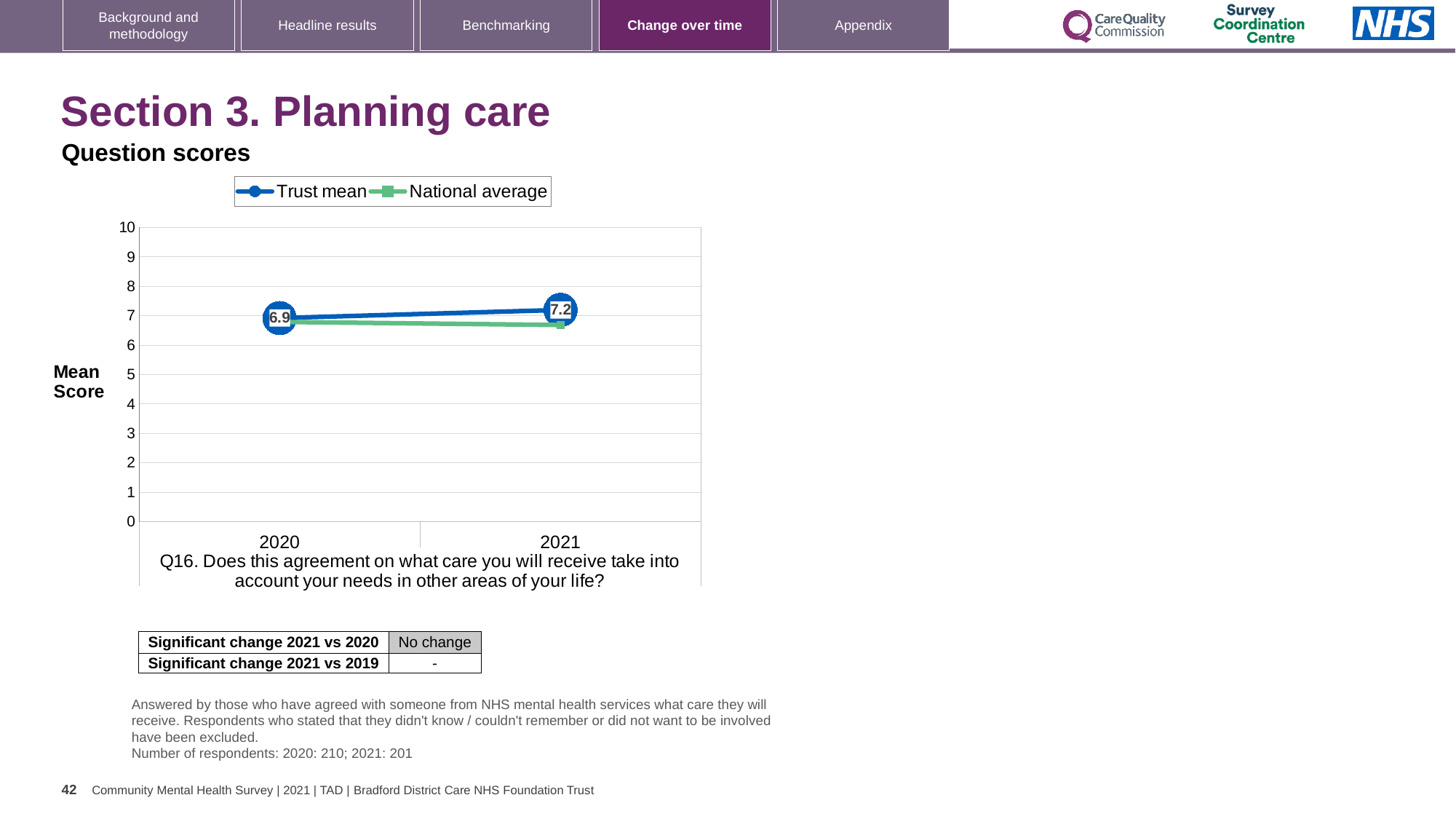
In 2021, which is higher, the Trust mean or the National average? Trust mean By how much did the Trust mean score change from 2020 to 2021? 0.3 Does the Trust mean score rise or fall from 2020 to 2021? rise What kind of chart is shown on the slide? line chart Is the National average value for 2021 greater or less than 7? less What is the Trust mean score for 2021? 7.2 What is the label on the y axis of the chart? Mean Score In which year is the Trust mean score highest? 2021 Which year has the higher Trust mean score, 2020 or 2021? 2021 How many series does the chart legend list? 2 How many years are plotted on the x axis of the chart? 2 What is the Trust mean score for 2020? 6.9